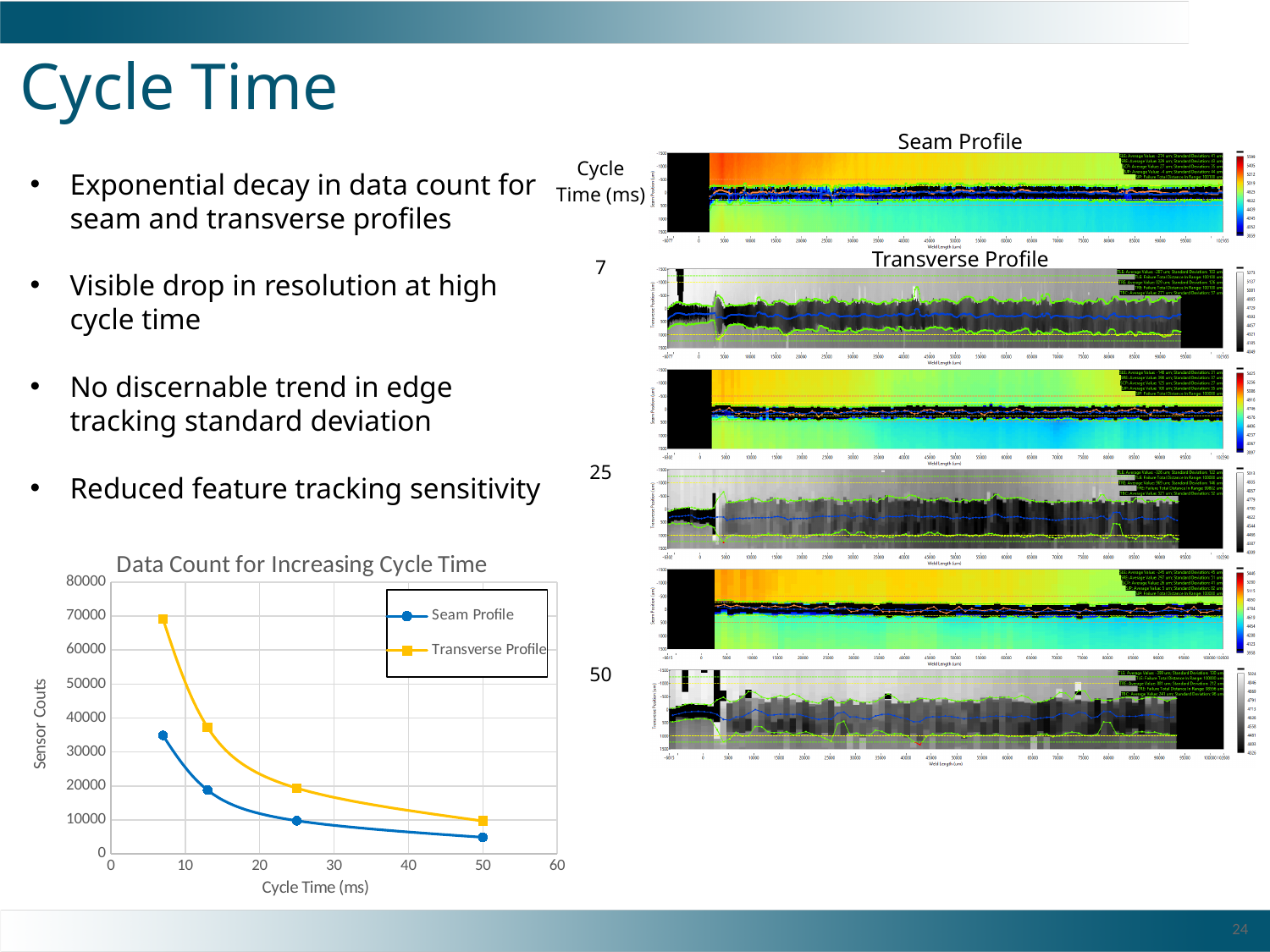
In the "Data Count for Increasing Cycle Time" chart, is the Transverse Profile value at its second data point (around 13 ms) greater or less than 30000? greater What are the two series named in the legend of the "Data Count for Increasing Cycle Time" chart? Seam Profile and Transverse Profile In the "Data Count for Increasing Cycle Time" chart, is the Seam Profile value at the lowest cycle time greater or less than 40000? less In the "Data Count for Increasing Cycle Time" chart, is the Seam Profile value at 50 ms greater or less than 10000? less Which series reaches the highest value in the "Data Count for Increasing Cycle Time" chart? Transverse Profile In the "Data Count for Increasing Cycle Time" chart, do the values rise or fall as cycle time increases? fall What is the x-axis label of the "Data Count for Increasing Cycle Time" chart? Cycle Time (ms) How many data points are plotted for the Seam Profile series in the "Data Count for Increasing Cycle Time" chart? 4 How many series does the legend of the "Data Count for Increasing Cycle Time" chart list? 2 In the "Data Count for Increasing Cycle Time" chart, which series has the higher value at the lowest cycle time? Transverse Profile What type of chart is "Data Count for Increasing Cycle Time"? line chart